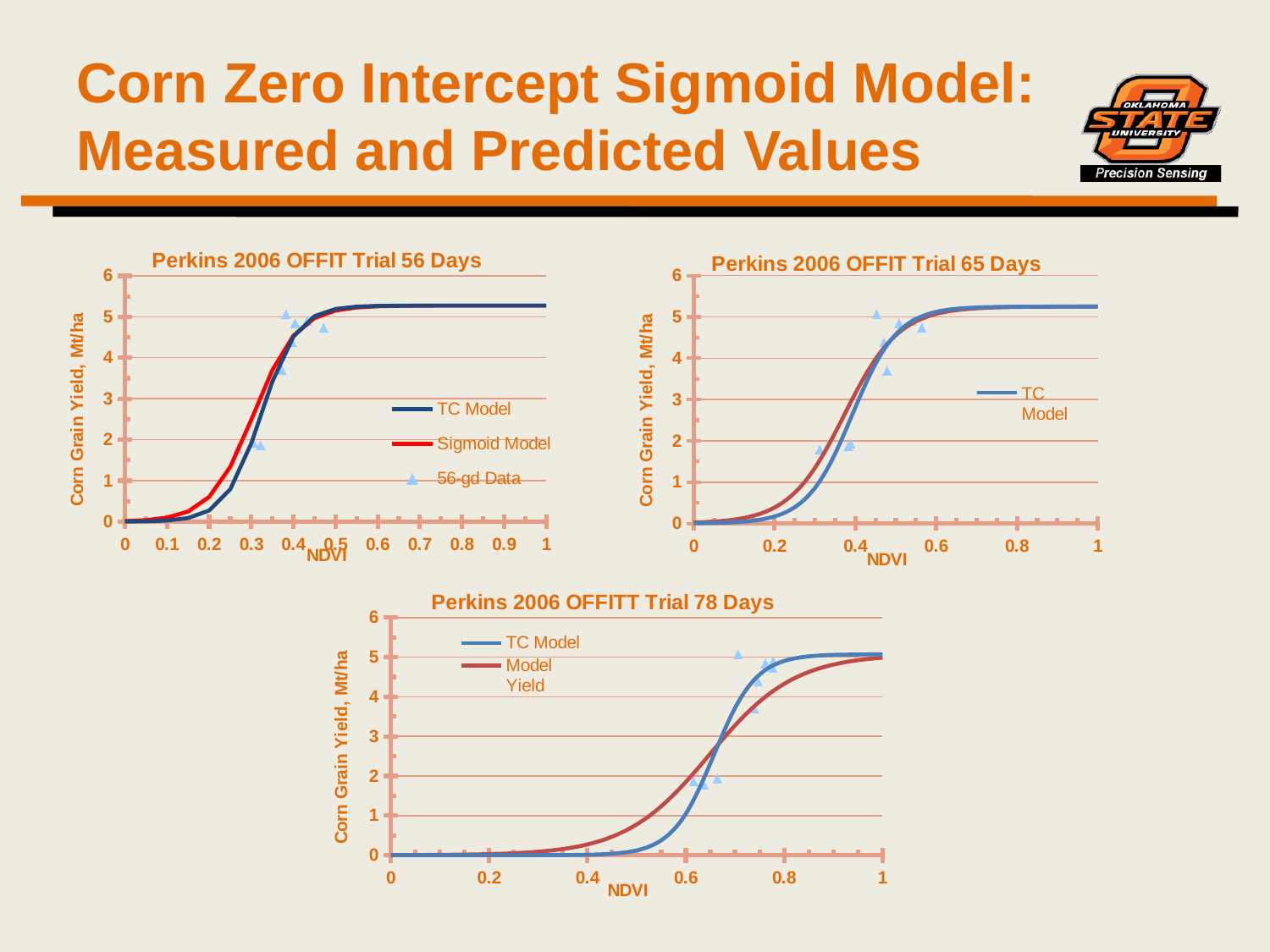
In the 'Perkins 2006 OFFIT Trial 56 Days' chart, how many series does the legend list? 3 How many charts are shown on the slide? 3 In the 'Perkins 2006 OFFITT Trial 78 Days' chart, how many series does the legend list? 2 In the 'Perkins 2006 OFFIT Trial 56 Days' chart, is the TC Model value at NDVI 0.8 greater or less than 5? greater In the 'Perkins 2006 OFFIT Trial 56 Days' chart, is the Sigmoid Model value at NDVI 0.2 greater or less than 1? less In the 'Perkins 2006 OFFITT Trial 78 Days' chart, is the Model Yield value at NDVI 0.8 greater or less than 4? greater What is the y-axis label of the 'Perkins 2006 OFFIT Trial 65 Days' chart? Corn Grain Yield, Mt/ha What kind of chart is the 'Perkins 2006 OFFIT Trial 56 Days' chart? line chart What are the legend entries in the 'Perkins 2006 OFFITT Trial 78 Days' chart? TC Model, Model Yield In the 'Perkins 2006 OFFIT Trial 56 Days' chart, do the TC Model values rise or fall as NDVI increases? rise In the 'Perkins 2006 OFFIT Trial 65 Days' chart, how many series does the legend list? 1